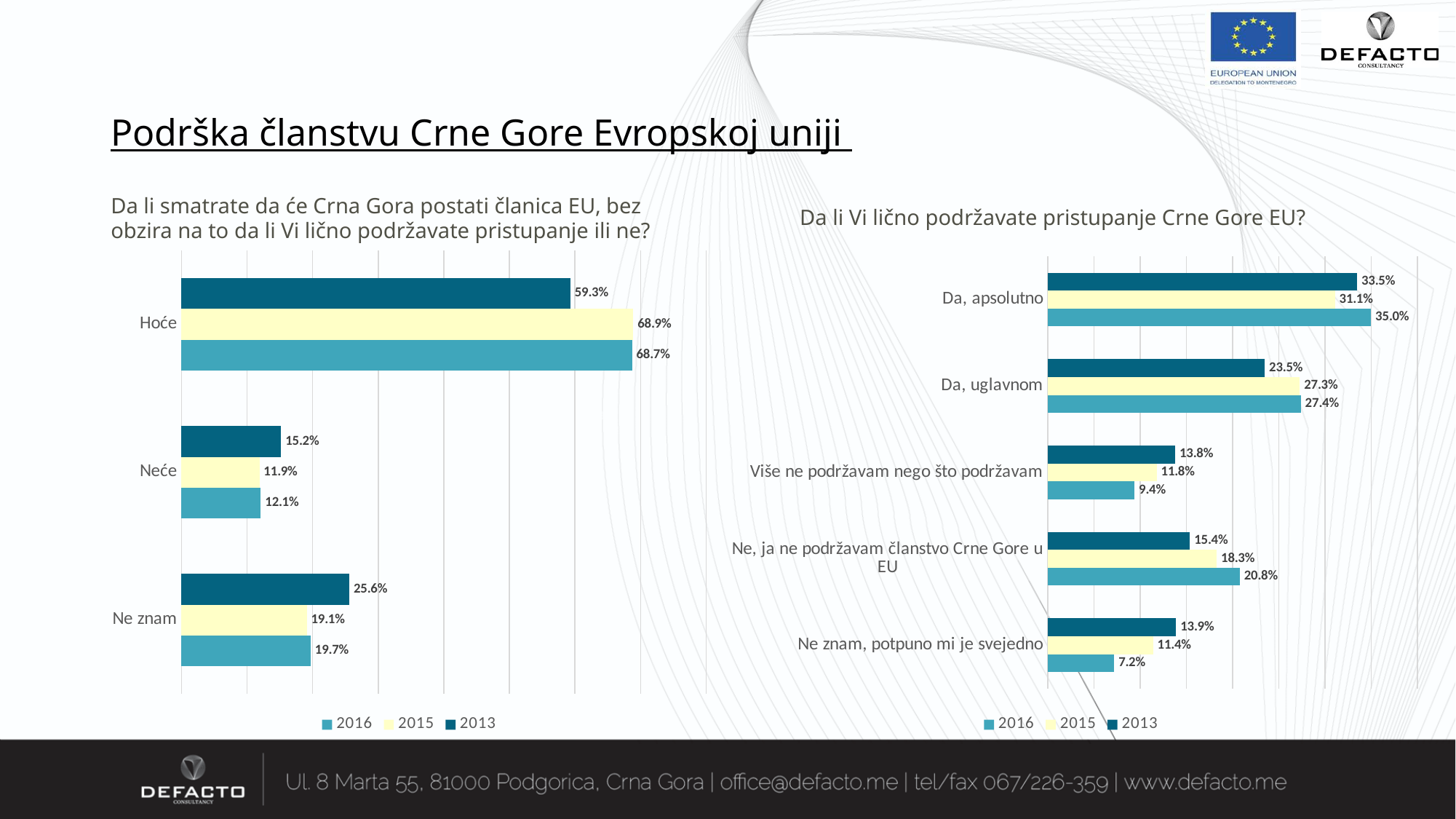
In the left chart, what is the difference between the 2015 and 2013 values for "Hoće"? 9.6 percentage points In the left chart, how many series does the legend list? 3 In the left chart, what is the 2013 value for "Ne znam"? 25.6% In the left chart, which category has the lowest 2016 value? Neće In the right chart, how many categories are shown? 5 In the right chart ("Da li Vi lično podržavate pristupanje Crne Gore EU?"), what is the 2016 value for "Da, apsolutno"? 35.0% In the right chart, which category has the highest 2013 value? Da, apsolutno In the right chart, what is the difference between the 2013 and 2016 values for "Ne znam, potpuno mi je svejedno"? 6.7 percentage points In the left chart ("Da li smatrate da će Crna Gora postati članica EU..."), what is the 2015 value for "Hoće"? 68.9% In the right chart, which is larger for "Ne, ja ne podržavam članstvo Crne Gore u EU": the 2016 value or the 2013 value? 2016 In the right chart, what is the 2013 value for "Da, uglavnom"? 23.5% What type of chart is the left chart? Bar chart